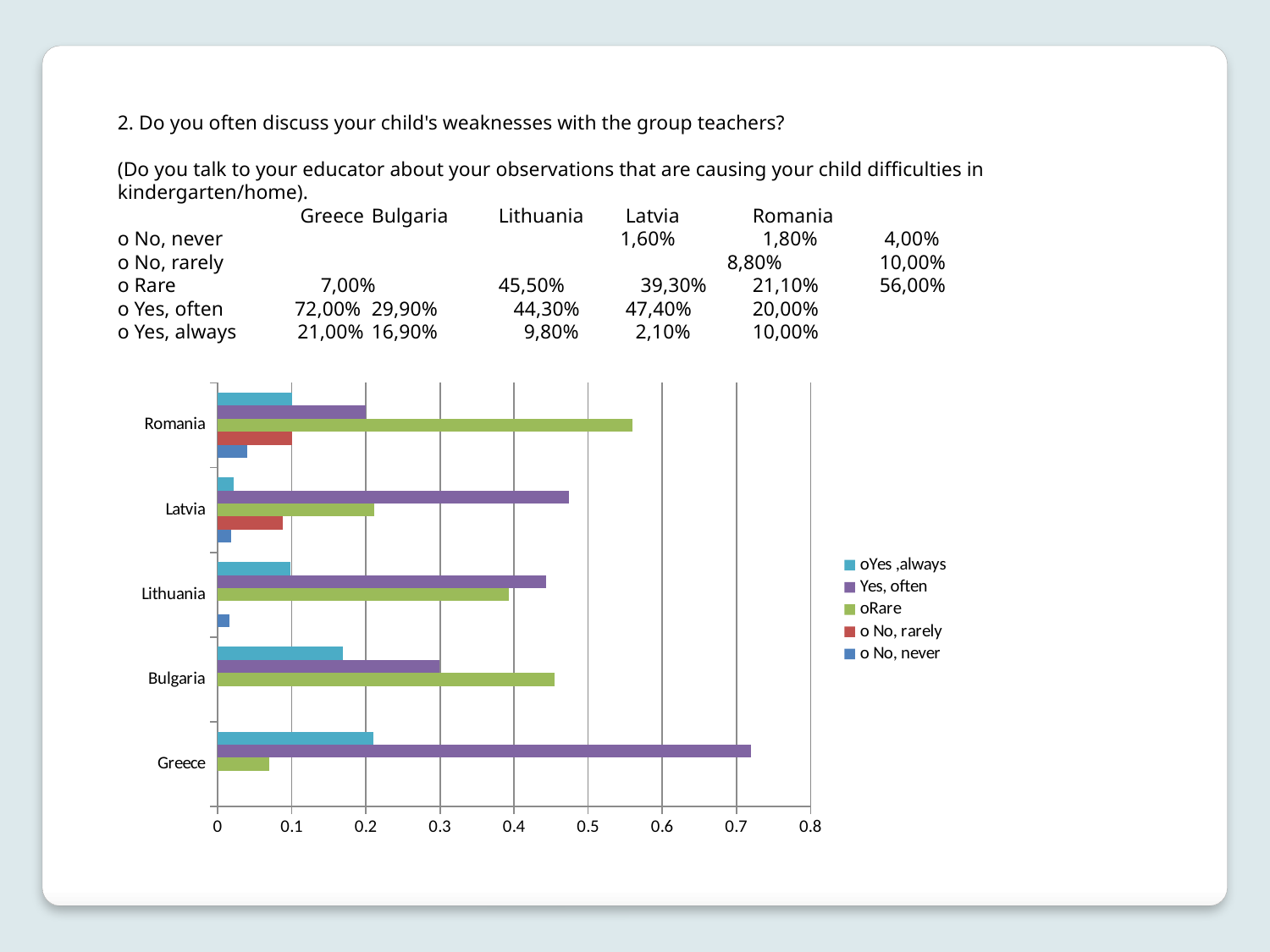
How many series does the chart's legend list? 5 Is the "Yes, often" value for Greece greater or less than 0.7? greater Which country has the lowest value for "Yes, always"? Latvia For Lithuania, which is larger: the "Yes, often" value or the "Rare" value? Yes, often What kind of chart is shown on the slide? bar chart Is the "Rare" value for Greece greater or less than 0.1? less Is the "Rare" value for Bulgaria greater or less than 0.4? greater Which series is shown in purple in the chart's legend? Yes, often Which country has the highest value for "Rare"? Romania How many countries are shown on the chart's vertical axis? 5 Which is larger: the "Yes, often" value for Latvia or the "Rare" value for Romania? Rare for Romania Which country has the highest value for "Yes, often"? Greece